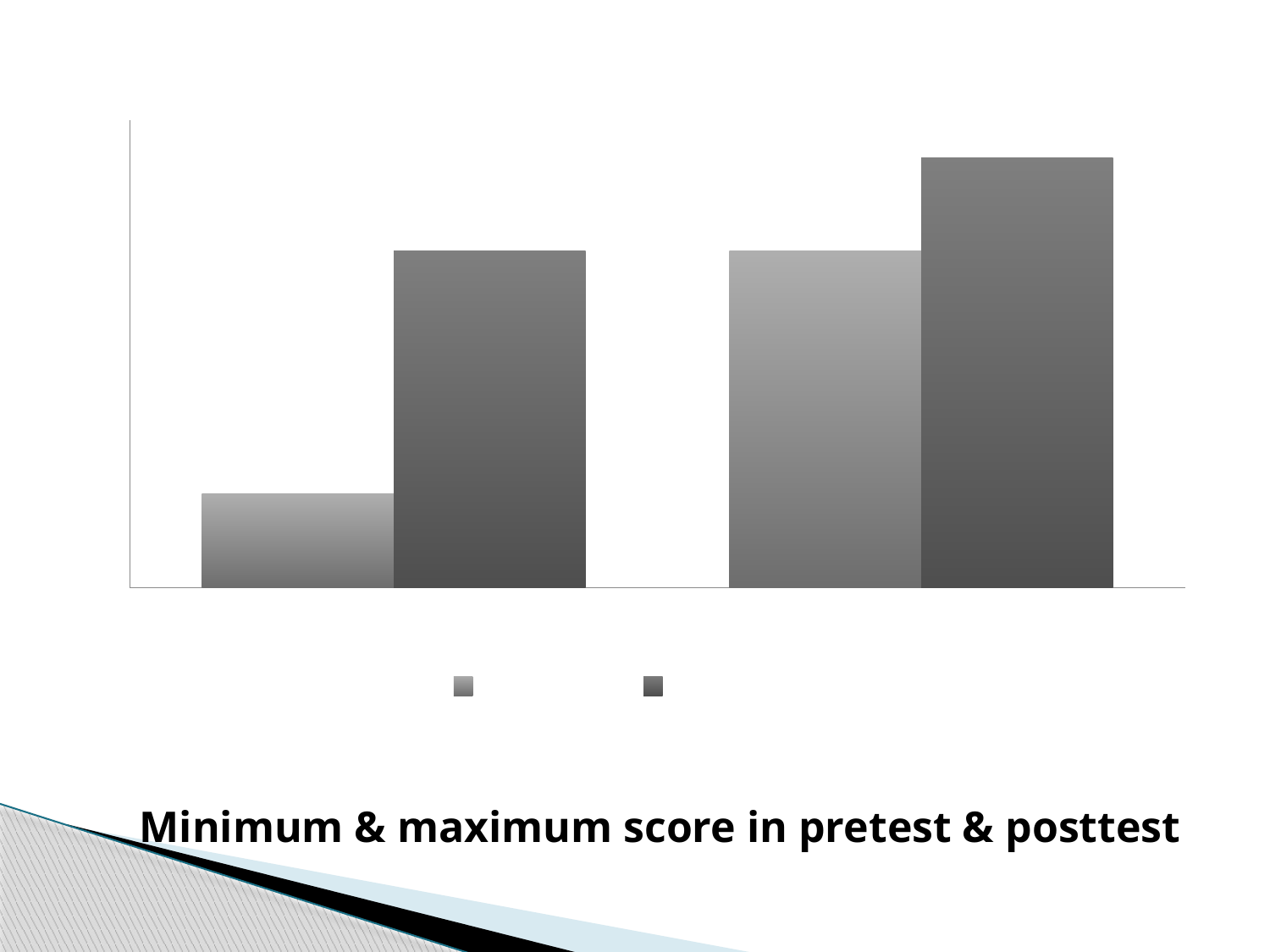
What kind of chart is shown on the slide? bar chart Do the darker-series bars rise or fall from the left group to the right group? rise In the left-hand group, is the lighter bar or the darker bar taller? the darker bar Which bar is the tallest on the chart: the lighter or the darker bar in the right-hand group? the darker bar What is the caption text shown beneath the chart on the slide? Minimum & maximum score in pretest & posttest How many entries does the chart's legend show? 2 Are the bars on the chart vertical or horizontal? vertical Do the lighter-series bars rise or fall from the left group to the right group? rise How many bars are plotted in total on the chart? 4 Which bar is the shortest on the chart: the lighter or the darker bar in the left-hand group? the lighter bar In the right-hand group, is the lighter bar or the darker bar taller? the darker bar How many groups of bars are plotted along the x axis? 2